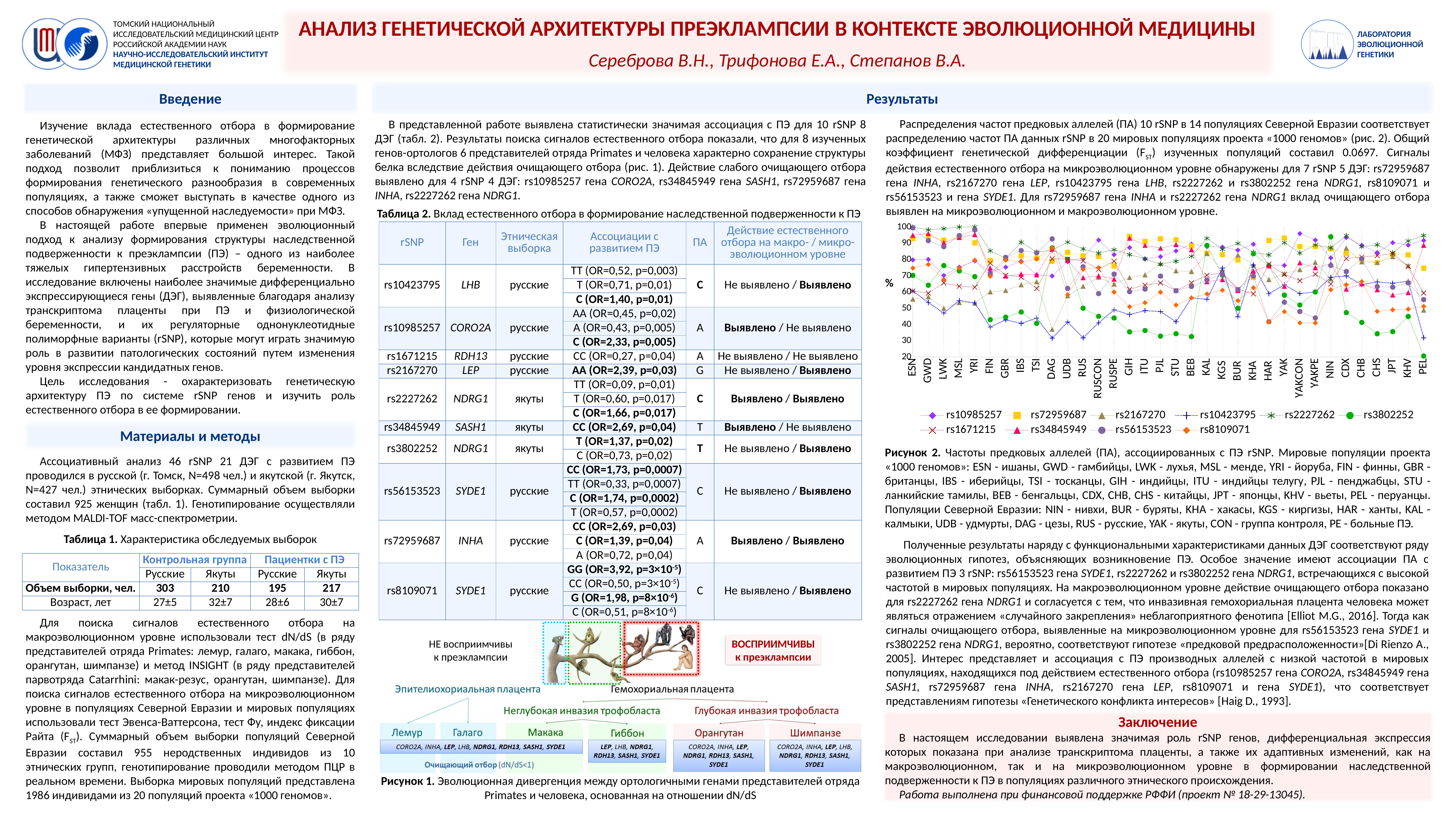
Which series in the chart in Рисунок 2 is drawn with green circle markers? rs3802252 What is the label on the y axis of the chart in Рисунок 2? % How many series does the legend of the chart in Рисунок 2 list? 10 In the chart in Рисунок 2, is the value for rs34845949 in ESN greater or less than 80? greater In the chart in Рисунок 2, is the value for rs2167270 in DAG greater or less than 40? less How many populations are shown along the x axis of the chart in Рисунок 2? 34 What is the first population on the x axis of the chart in Рисунок 2? ESN What kind of chart is shown in Рисунок 2 on the slide? line chart What is the last population on the x axis of the chart in Рисунок 2? PEL In the chart in Рисунок 2, is the value for rs3802252 in PEL greater or less than 30? less